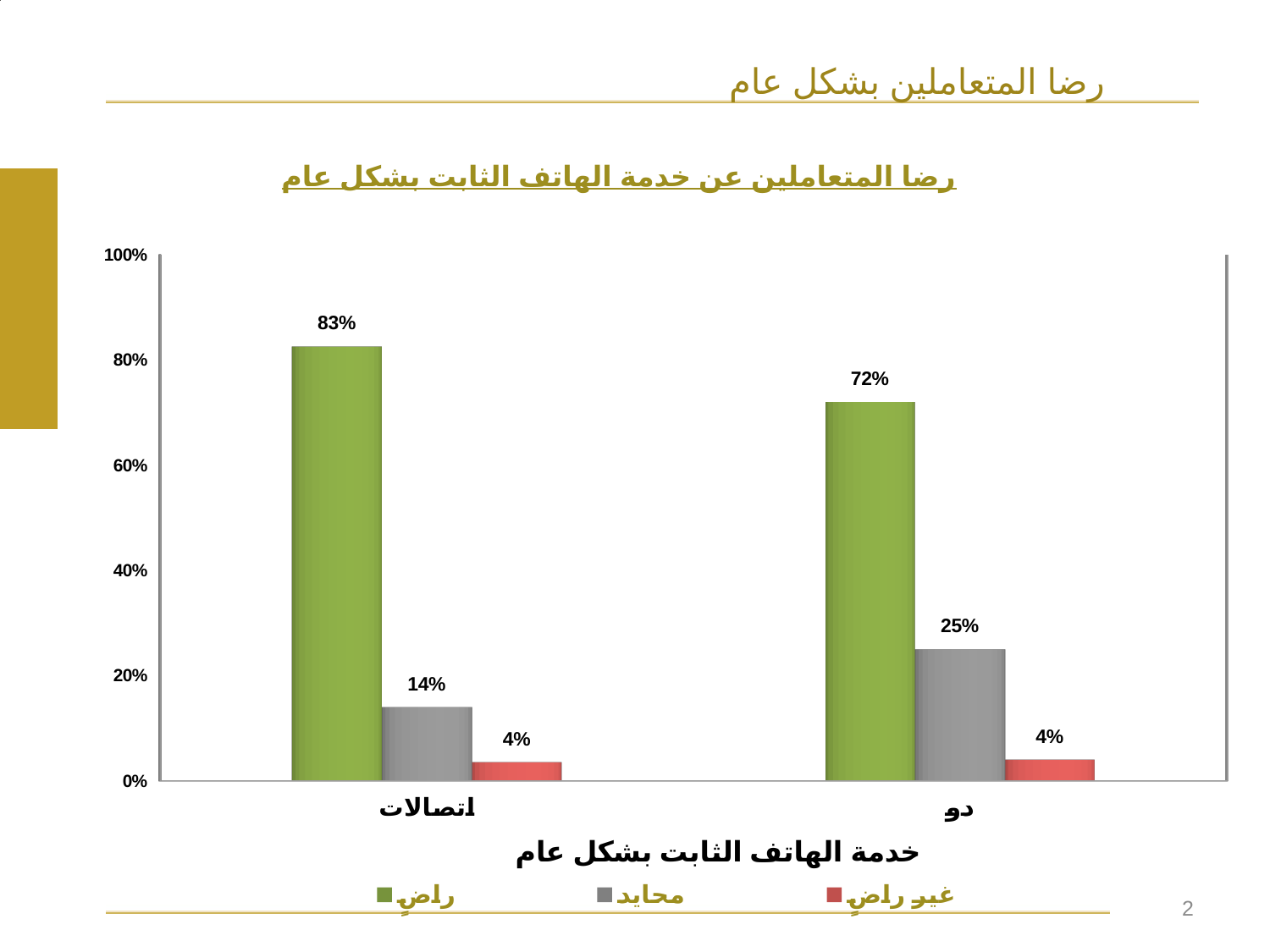
What percentage of اتصالات customers are راضٍ (satisfied) with the fixed-line telephone service? 83% What is the difference between the محايد (neutral) values for دو and اتصالات? 11% What is the غير راضٍ (dissatisfied) value for اتصالات? 4% How many series does the legend list? 3 Which category has the lowest محايد (neutral) value? اتصالات What is the محايد (neutral) value for دو? 25% What is the محايد (neutral) value for اتصالات? 14% What kind of chart is shown on the slide? Bar chart Which category has the higher راضٍ (satisfied) value, اتصالات or دو? اتصالات What percentage of دو customers are راضٍ (satisfied)? 72% How many categories are shown on the x axis? 2 What is the difference between the راضٍ (satisfied) values for اتصالات and دو? 11%